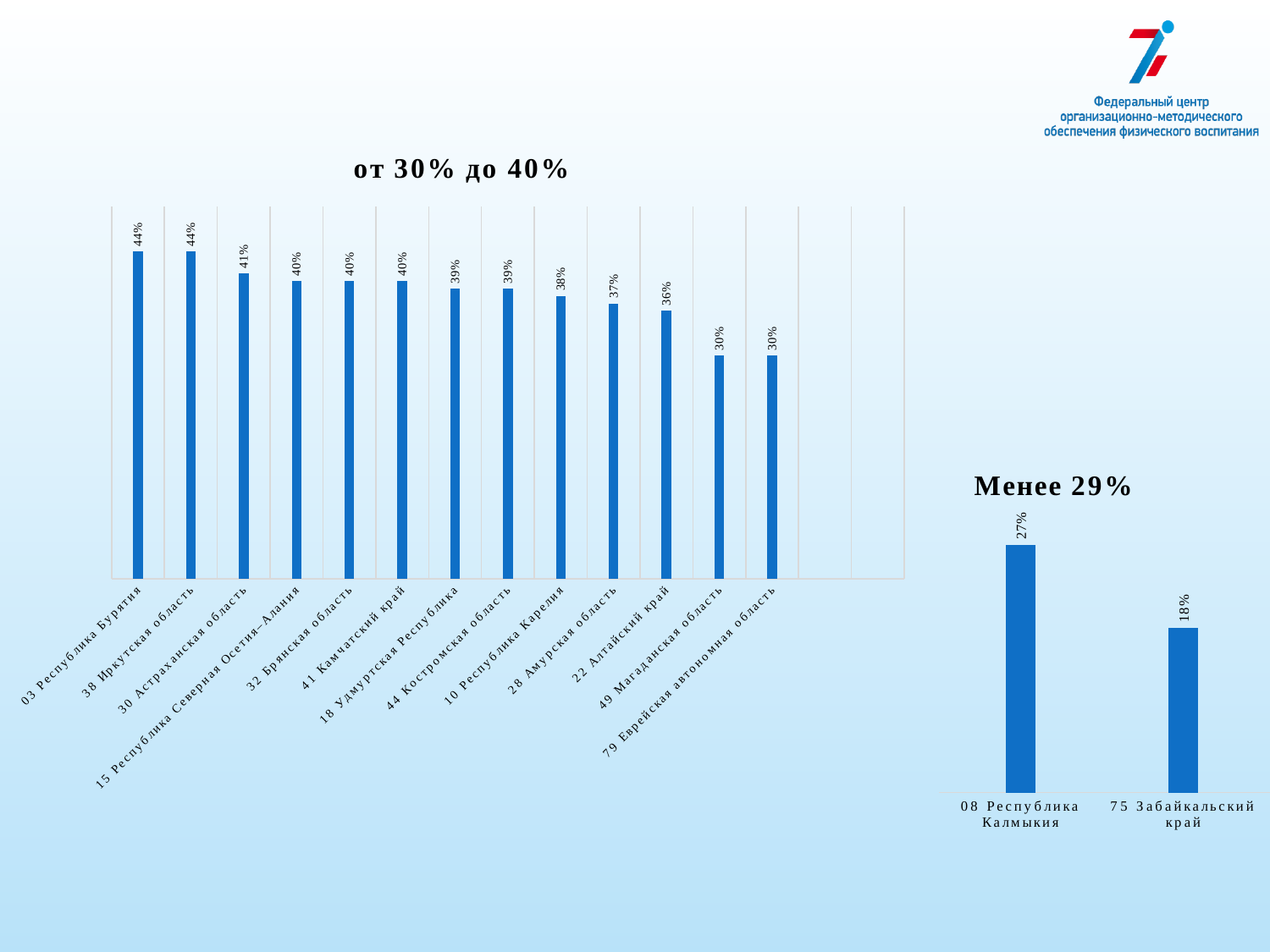
In the chart titled "от 30% до 40%", do the values rise or fall from left to right along the x axis? fall In the chart titled "от 30% до 40%", what is the value for 30 Астраханская область? 41% In the chart titled "от 30% до 40%", what is the difference between the values for 03 Республика Бурятия and 28 Амурская область? 7% In the chart titled "Менее 29%", what is the value for 08 Республика Калмыкия? 27% In the chart titled "Менее 29%", which category has the lowest value? 75 Забайкальский край In the chart titled "от 30% до 40%", what is the value for 49 Магаданская область? 30% In the chart titled "от 30% до 40%", how many categories are plotted? 13 What kind of chart is the chart titled "Менее 29%"? bar chart In the chart titled "от 30% до 40%", what is the value for 22 Алтайский край? 36% In the chart titled "от 30% до 40%", what is the value for 10 Республика Карелия? 38% In the chart titled "от 30% до 40%", which is larger: the value for 32 Брянская область or the value for 44 Костромская область? 32 Брянская область In the chart titled "Менее 29%", what is the difference between the values for 08 Республика Калмыкия and 75 Забайкальский край? 9%